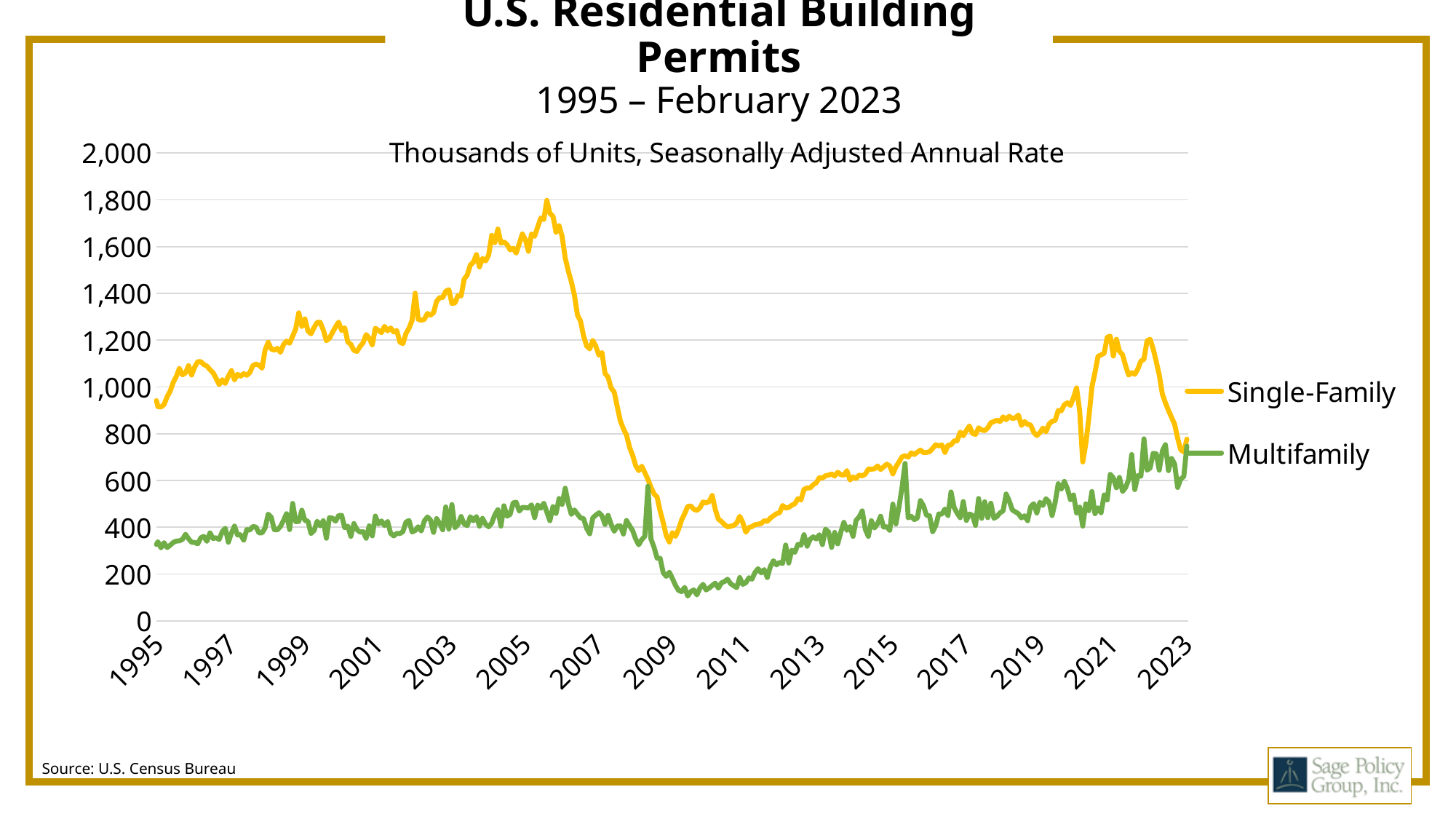
Does the Multifamily series rise or fall between 2010 and 2022? Rise Is the Single-Family value at the start of 1995 greater or less than 1,000? less Around 2005, which series has the larger value, Single-Family or Multifamily? Single-Family What unit are the values on the chart expressed in, according to the subtitle? Thousands of Units, Seasonally Adjusted Annual Rate Does the Single-Family series rise or fall between 2006 and 2009? Fall Which series reaches the highest value anywhere on the chart? Single-Family Is the Single-Family value at its 2021 peak greater or less than 1,000? greater How many series does the legend list? 2 Is the peak value of the Single-Family series around 2005–2006 greater or less than 1,600? greater What kind of chart is shown on the slide? Line chart What is the title of the chart? U.S. Residential Building Permits